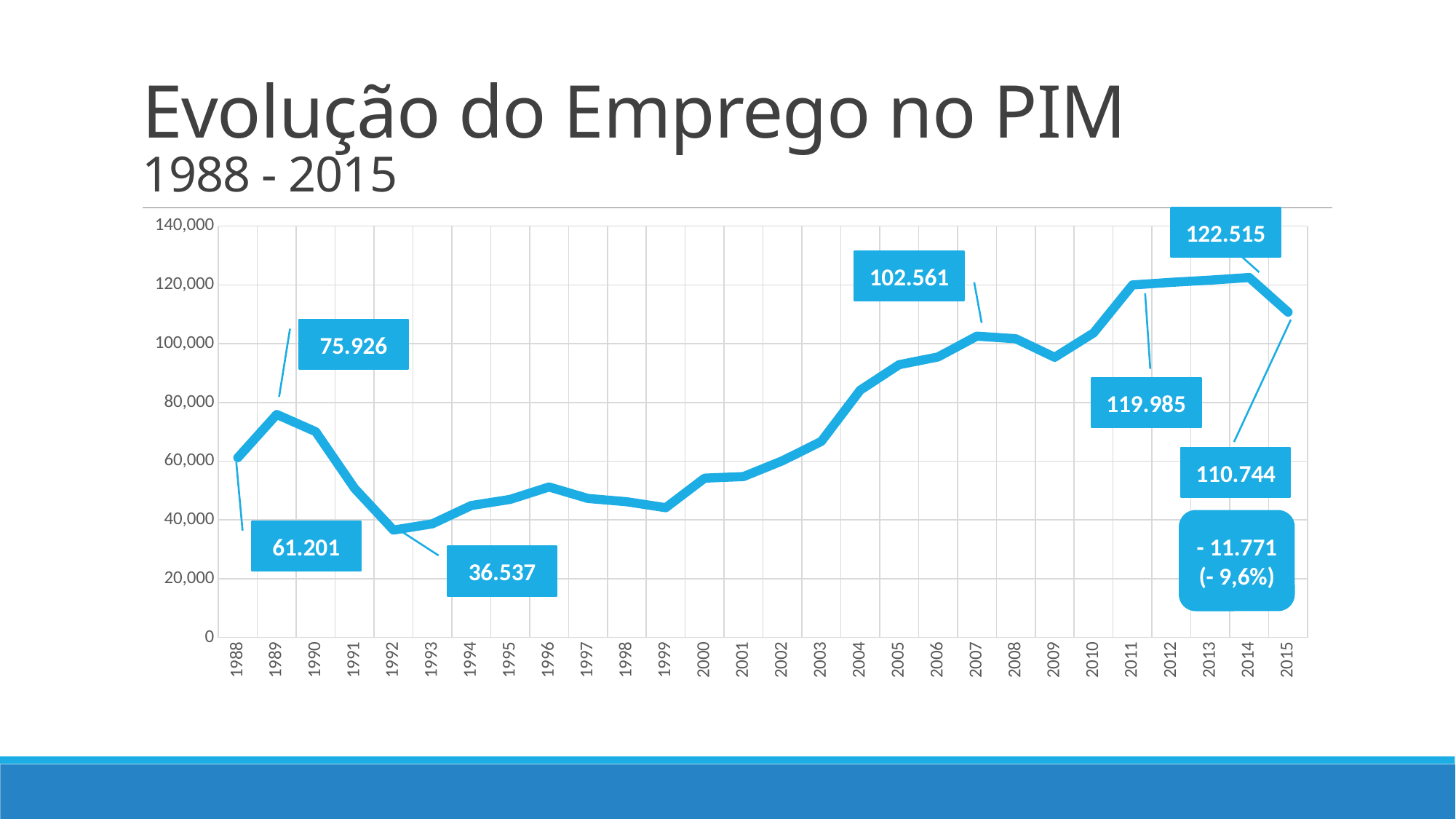
Which year has the lowest employment value on the chart? 1992 What is the employment value labelled for 1989? 75.926 How many years are plotted on the x axis? 28 What type of chart is shown on the slide? line chart Which year has the highest employment value on the chart? 2014 What is the employment value labelled for 2014? 122.515 What is the employment value labelled for 1992? 36.537 What is the employment value labelled for 2015? 110.744 What is the employment value labelled for 1988? 61.201 Is the employment value for 1999 greater or less than 60,000? less What is the employment value labelled for 2007? 102.561 What is the change in employment from 2014 to 2015 as shown on the slide? - 11.771 (- 9,6%)